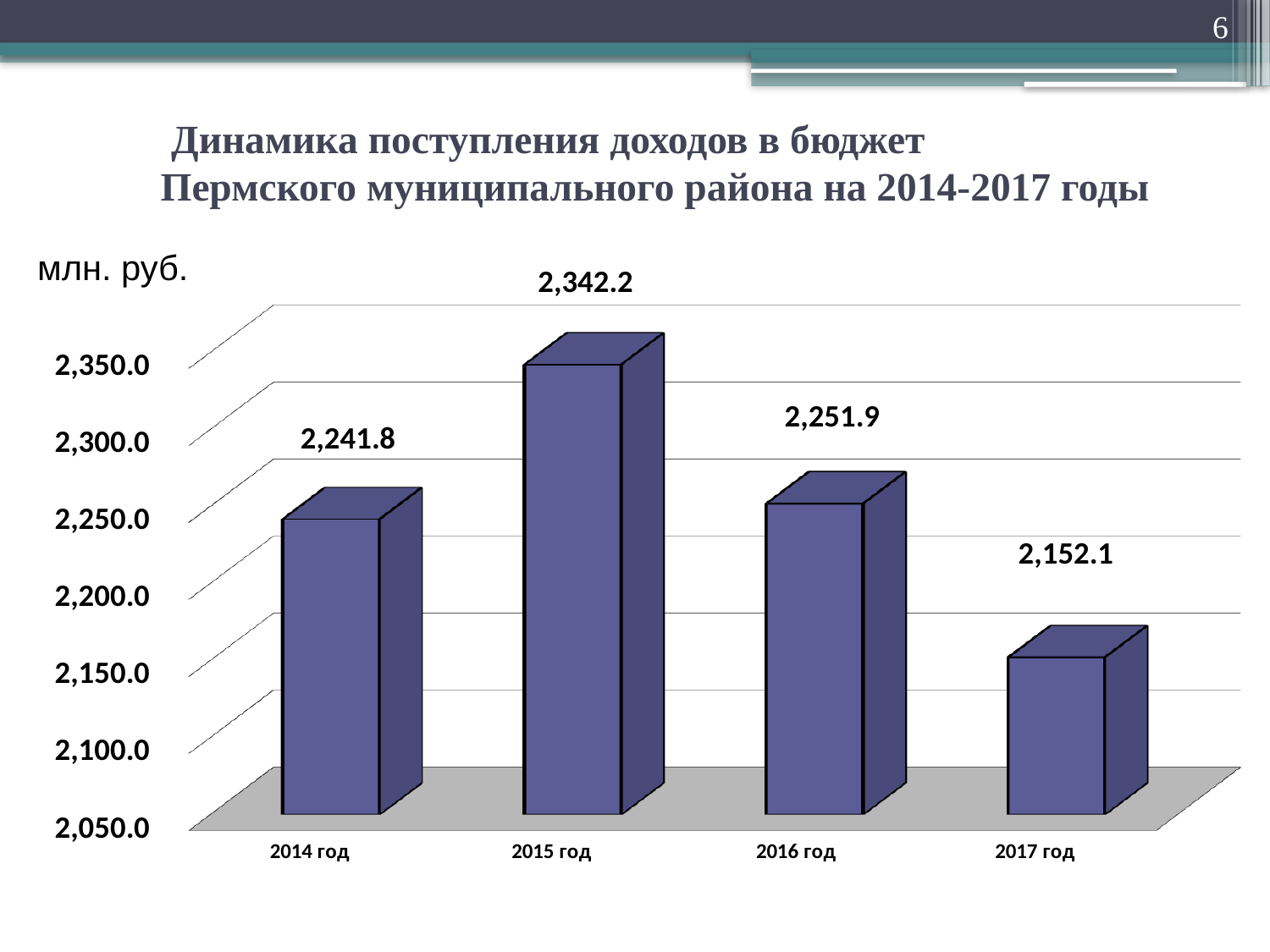
What is the value for 2015 год? 2,342.2 Which year has the lowest value? 2017 год Which year has the highest value? 2015 год What is the value for 2016 год? 2,251.9 What unit is indicated above the chart's vertical axis? млн. руб. What kind of chart is shown on the slide? bar chart Do the values rise or fall from 2015 год to 2017 год? fall What is the value for 2017 год? 2,152.1 How many years are shown on the chart? 4 Which is larger, the value for 2014 год or 2016 год? 2016 год What is the difference between the values for 2015 год and 2017 год? 190.1 What is the value for 2014 год? 2,241.8